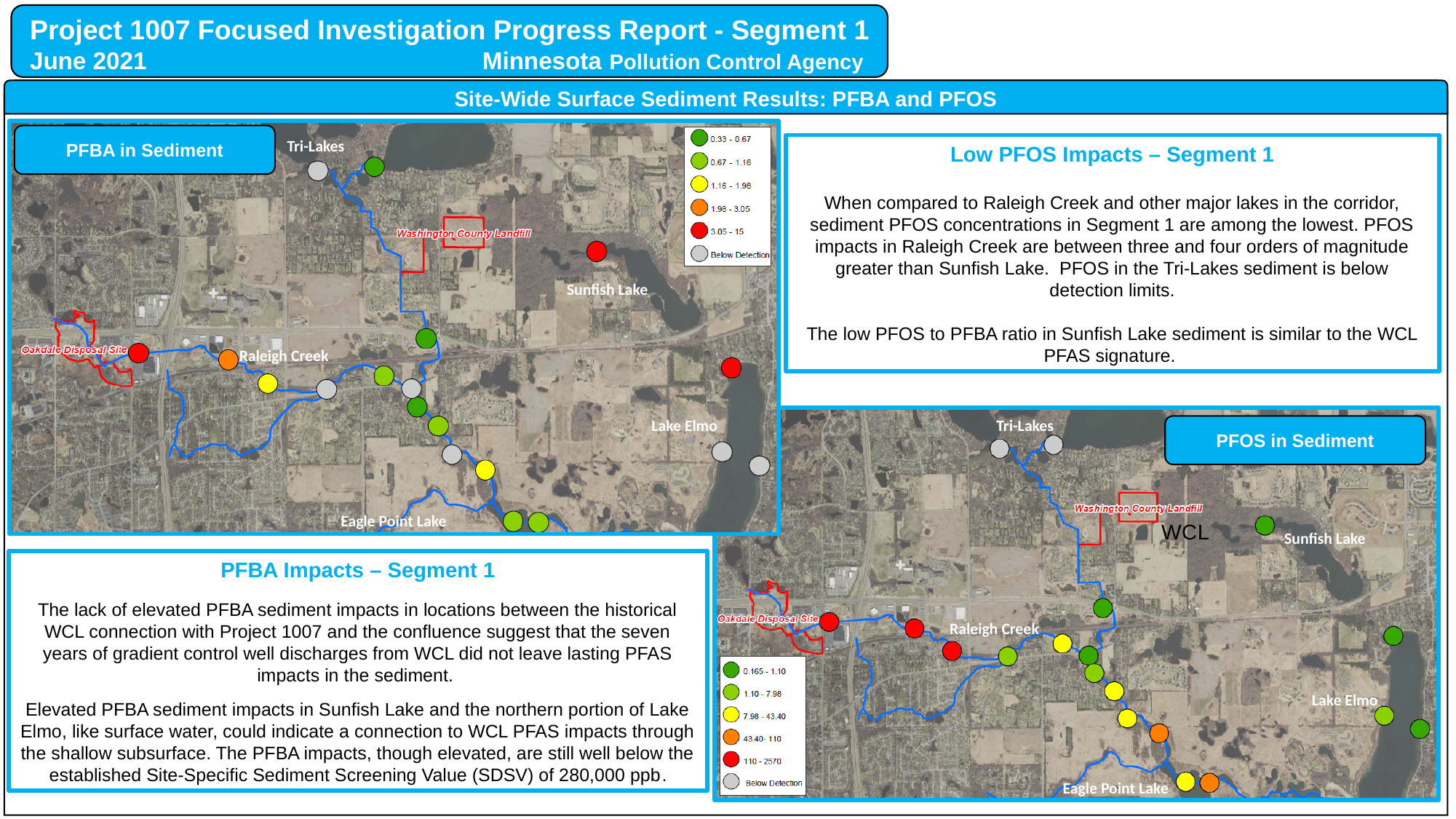
In the PFBA in Sediment map legend, what does the gray marker represent? Below Detection In the PFOS in Sediment map legend, how many classes are listed in total, including Below Detection? 6 In the PFOS in Sediment map, which location has higher sediment PFOS, Raleigh Creek or Sunfish Lake? Raleigh Creek In the PFOS in Sediment map, which legend class do the Tri-Lakes markers fall in? Below Detection In the PFBA in Sediment map, which legend class does the Sunfish Lake marker fall in? 3.05 - 15 In the PFBA in Sediment map, which legend class does the marker at the Oakdale Disposal Site fall in? 3.05 - 15 In the PFOS in Sediment map, what is the lowest concentration range shown in the legend? 0.165 - 1.10 In the PFOS in Sediment map legend, what concentration range does the orange marker represent? 43.40 - 110 In the PFBA in Sediment map, what is the highest concentration range shown in the legend? 3.05 - 15 In the PFBA in Sediment map legend, how many concentration ranges are listed, not counting Below Detection? 5 In the PFBA in Sediment map, which location has higher sediment PFBA, Sunfish Lake or Tri-Lakes? Sunfish Lake In the PFOS in Sediment map, which legend class does the Sunfish Lake marker fall in? 0.165 - 1.10